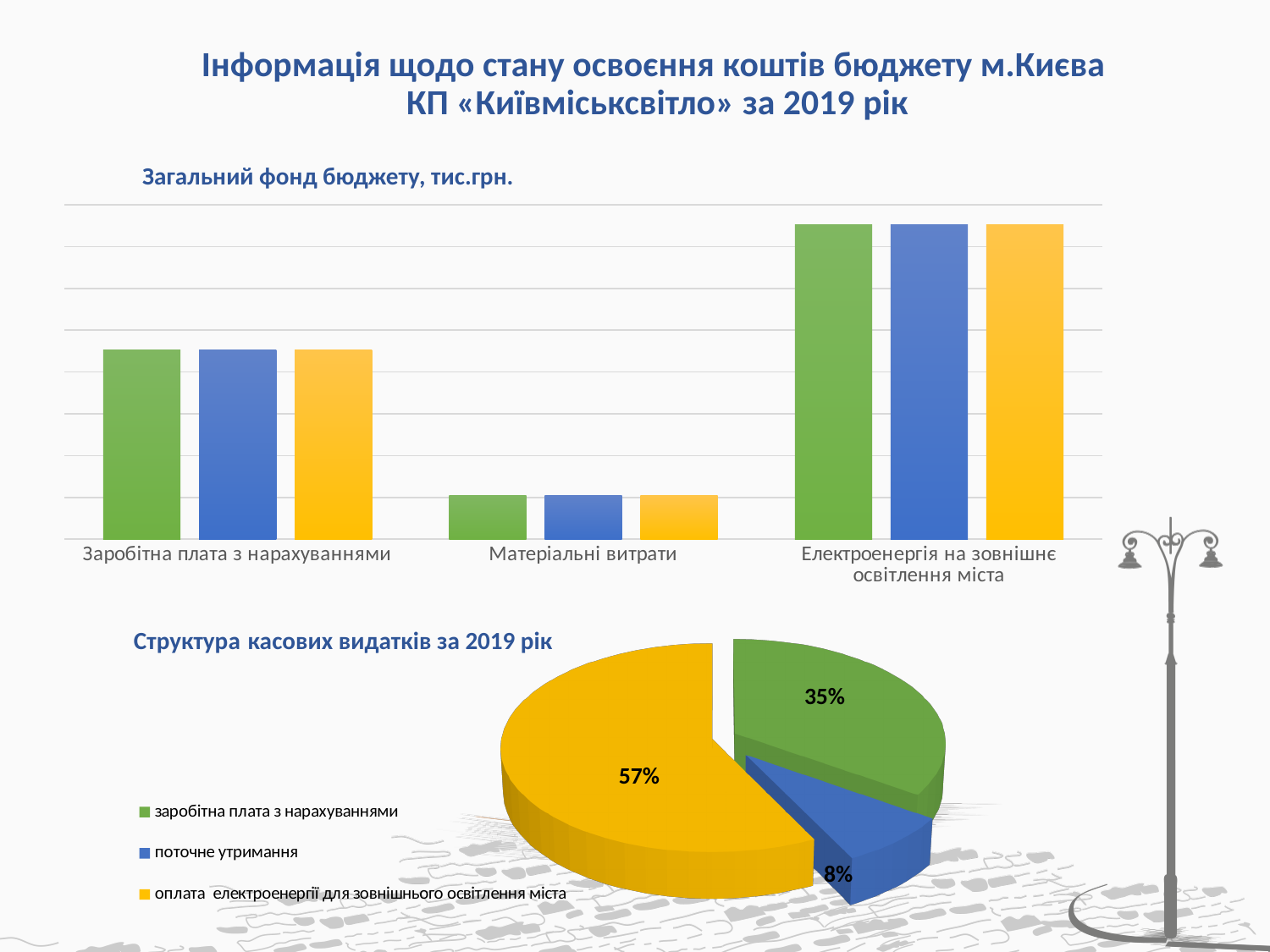
In the chart titled "Загальний фонд бюджету, тис.грн.", which category has larger bars: "Заробітна плата з нарахуваннями" or "Матеріальні витрати"? Заробітна плата з нарахуваннями What kind of chart is the chart titled "Загальний фонд бюджету, тис.грн."? bar chart What kind of chart is the chart titled "Структура касових видатків за 2019 рік"? pie chart In the chart titled "Структура касових видатків за 2019 рік", what share is shown for "заробітна плата з нарахуваннями"? 35% In the chart titled "Структура касових видатків за 2019 рік", which slice is the largest? оплата електроенергії для зовнішнього освітлення міста How many categories are shown on the x axis of the chart titled "Загальний фонд бюджету, тис.грн."? 3 In the chart titled "Загальний фонд бюджету, тис.грн.", which category has the lowest bars? Матеріальні витрати In the chart titled "Структура касових видатків за 2019 рік", what share is shown for "оплата електроенергії для зовнішнього освітлення міста"? 57% In the chart titled "Структура касових видатків за 2019 рік", what is the difference between the largest slice and the smallest slice? 49% In the chart titled "Структура касових видатків за 2019 рік", what share is shown for "поточне утримання"? 8% How many entries does the legend of the chart titled "Структура касових видатків за 2019 рік" list? 3 In the chart titled "Загальний фонд бюджету, тис.грн.", which category has the highest bars? Електроенергія на зовнішнє освітлення міста